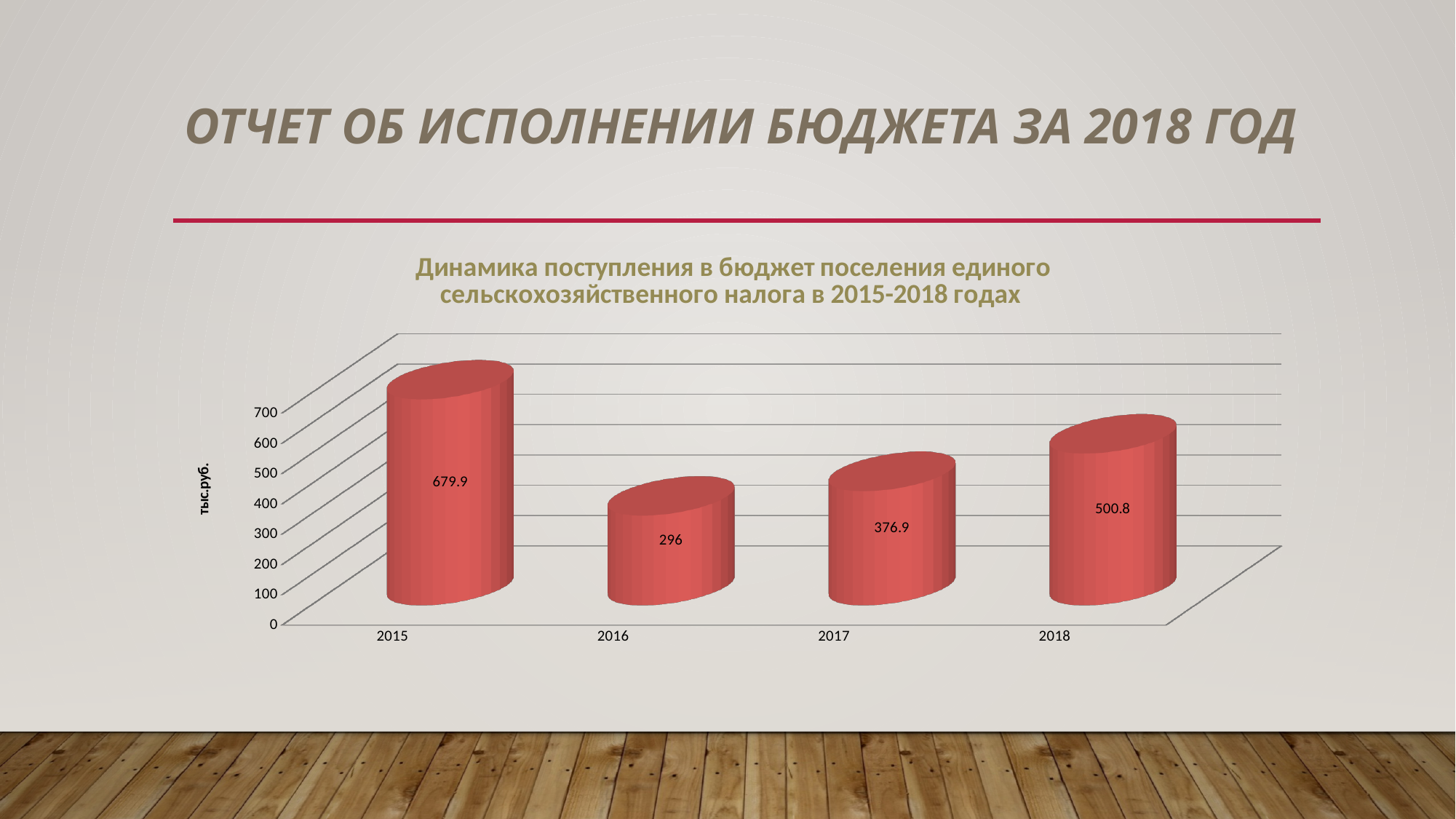
What is the value for 2016? 296 What is the unit label on the vertical axis? тыс.руб. Which year has the highest value? 2015 What is the value for 2018? 500.8 What kind of chart is shown on the slide? bar chart What is the difference between the values for 2015 and 2018? 179.1 Which is larger, the value for 2017 or the value for 2018? 2018 What is the difference between the values for 2017 and 2016? 80.9 What is the value for 2015? 679.9 Which year has the lowest value? 2016 How many years are shown on the x axis? 4 What is the value for 2017? 376.9